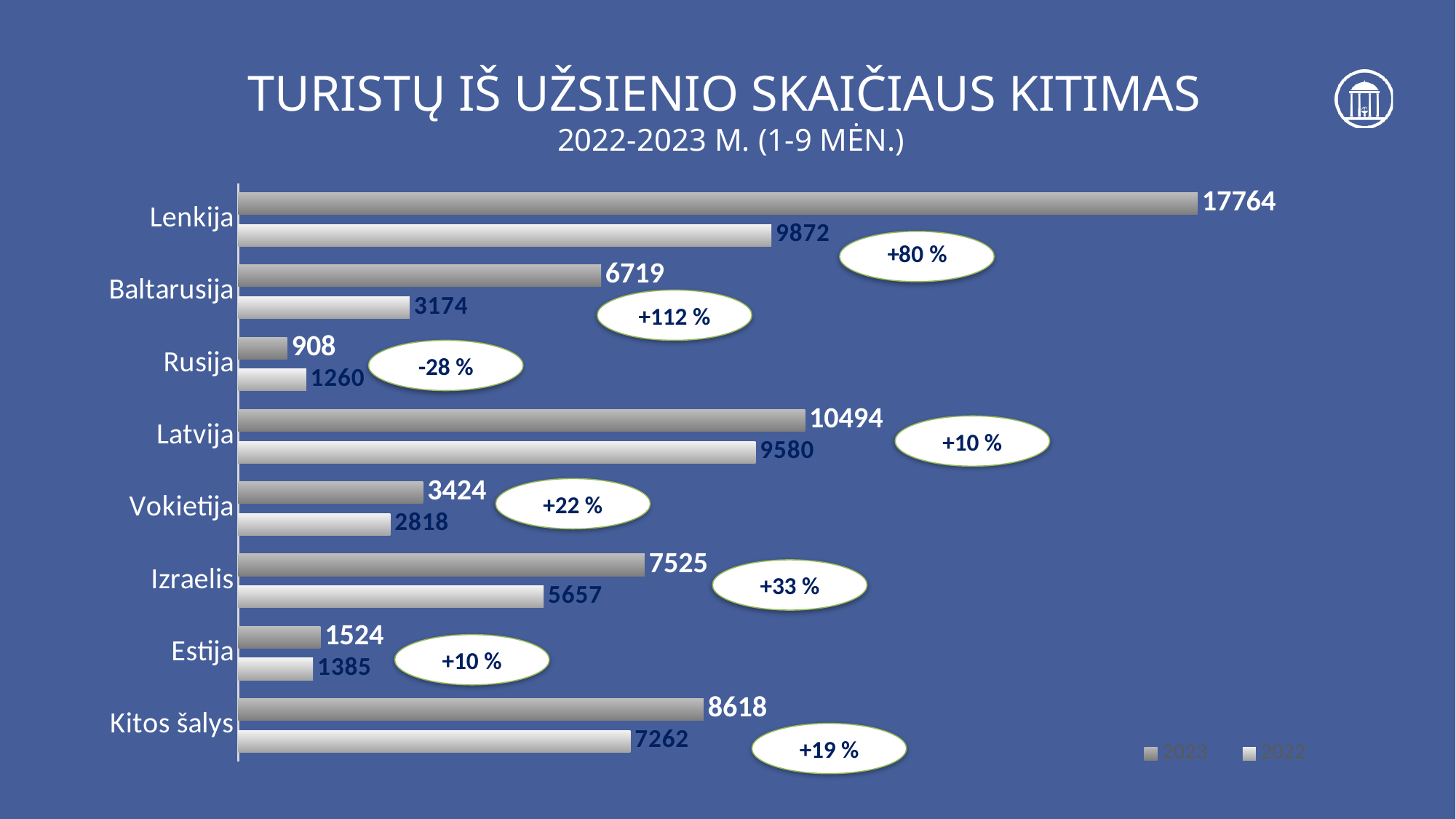
How many categories are shown on the chart? 8 What is the 2022 value for Kitos šalys? 7262 What is the 2022 value for Baltarusija? 3174 What is the 2023 value for Lenkija? 17764 Which is larger for Rusija, the 2023 value or the 2022 value? 2022 What is the 2023 value for Rusija? 908 What kind of chart is shown on the slide? Bar chart Which category has the lowest 2022 value? Rusija How many series does the legend list? 2 What percentage change is shown in the oval next to Baltarusija? +112 % Which category has the highest 2023 value? Lenkija What is the difference between the 2023 and 2022 values for Latvija? 914